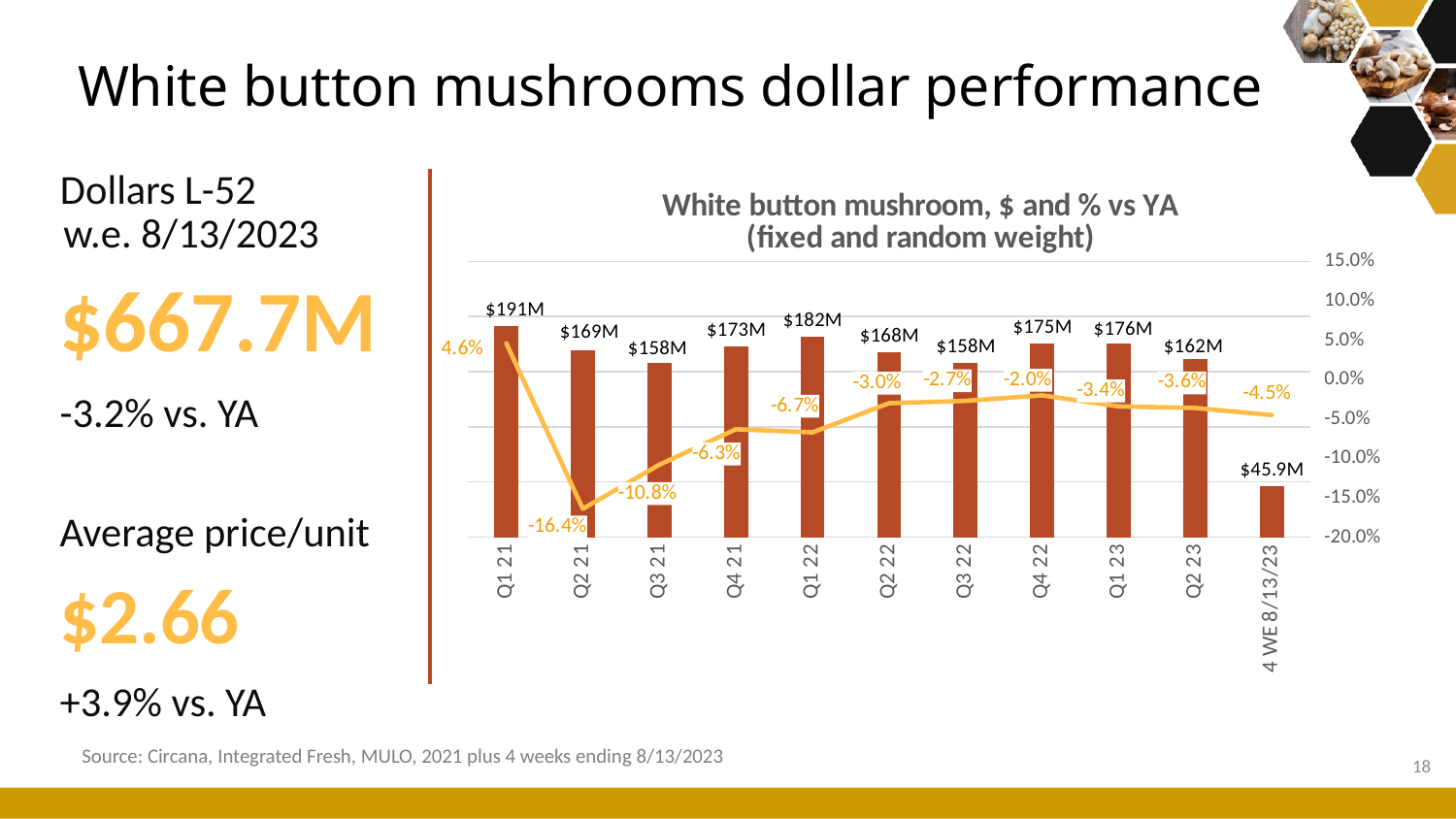
Does the % vs YA line rise or fall from Q2 21 to Q4 22? Rise How many periods are shown on the x axis? 11 What is the difference in dollar value between Q1 21 and Q2 21? $22M What is the dollar value shown for the 4 WE 8/13/23 period? $45.9M Which period has the lowest % vs YA value? Q2 21 What is the title of the chart? White button mushroom, $ and % vs YA (fixed and random weight) What is the dollar value shown for Q1 21? $191M What kind of chart is this? Combined bar and line chart What is the % vs YA value shown for Q4 22? -2.0% Which period has the highest dollar value? Q1 21 What is the % vs YA value shown for Q2 21? -16.4% Which has the larger dollar value, Q1 22 or Q4 22? Q1 22